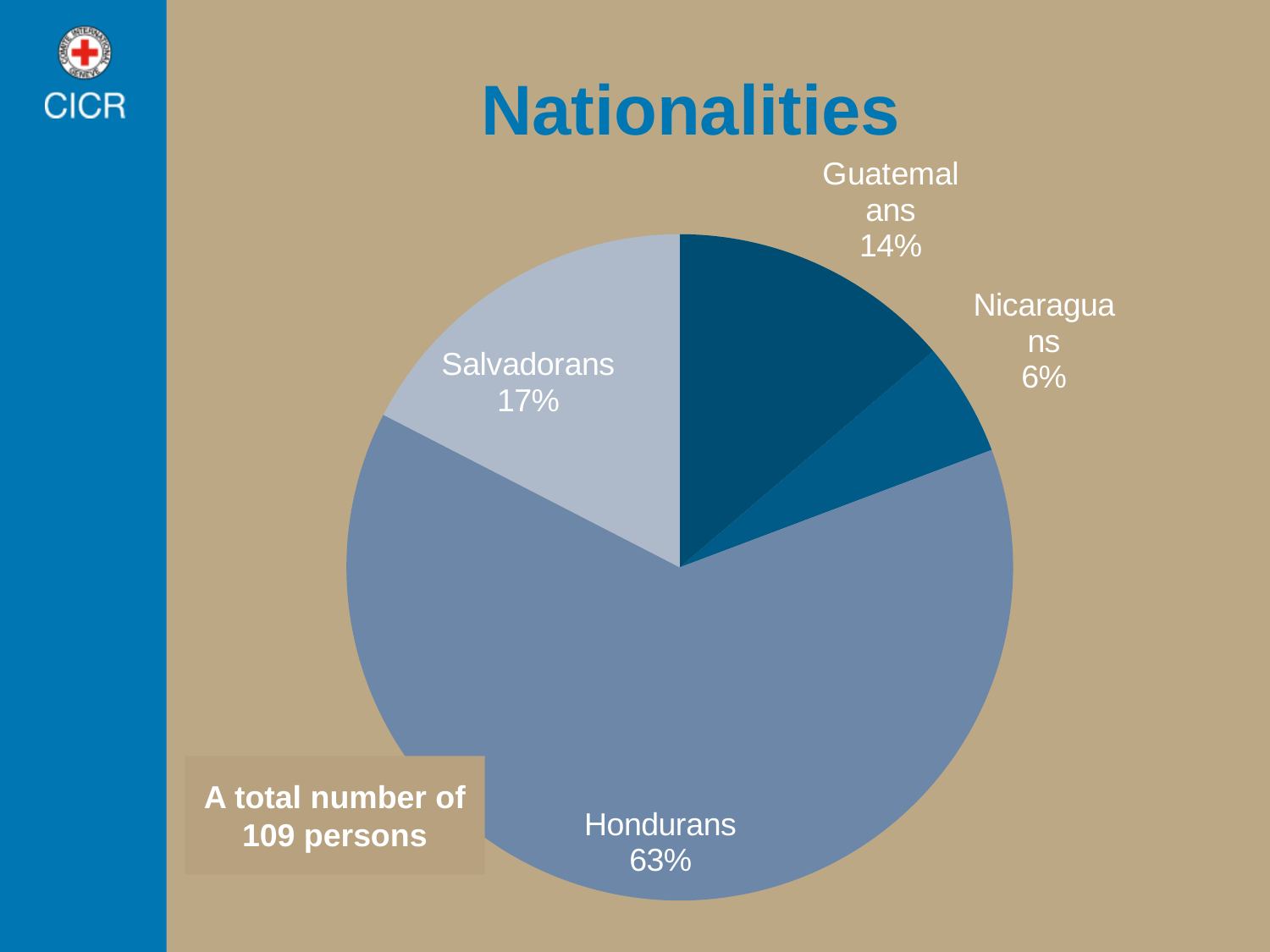
Which is larger, the share for Guatemalans or the share for Nicaraguans? Guatemalans What kind of chart is shown on the slide? pie chart Which nationality has the smallest slice of the pie? Nicaraguans What is the difference in percentage points between Salvadorans and Guatemalans? 3 What percentage is shown for Salvadorans? 17% What share of the pie do Hondurans represent? 63% What percentage is shown for Nicaraguans? 6% What is the title of the chart? Nationalities How many nationalities are shown in the pie chart? 4 What is the difference in percentage points between Hondurans and Salvadorans? 46 What percentage is shown for Guatemalans? 14% Which nationality has the largest slice of the pie? Hondurans